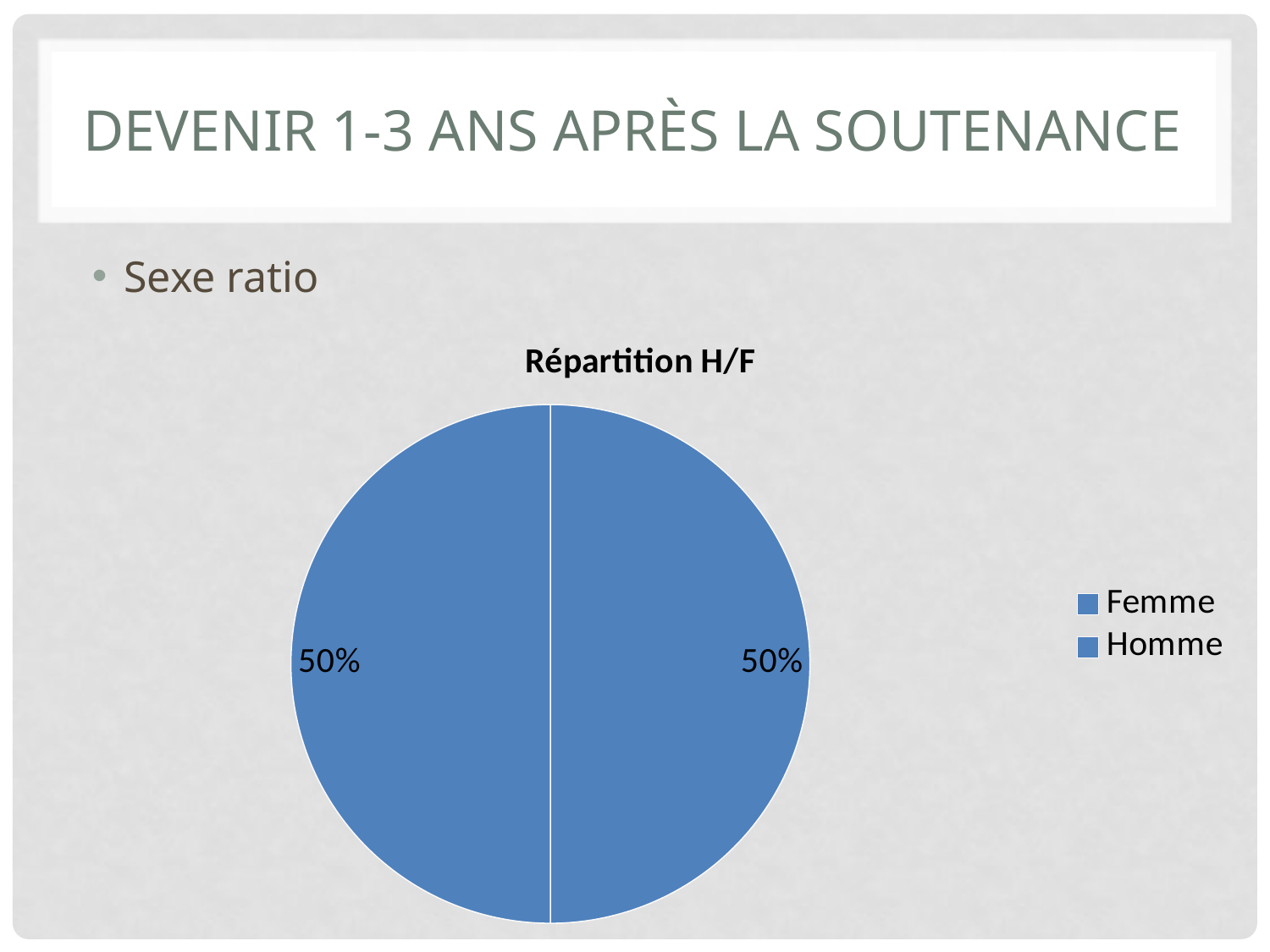
What value is printed on the right slice of the pie? 50% How many entries does the chart legend list? 2 How many slices does the pie chart have? 2 What share of the pie is labelled for Femme? 50% What is the difference between the Femme share and the Homme share? 0% What share of the pie is labelled for Homme? 50% What value is printed on the left slice of the pie? 50% What kind of chart is shown on the slide? pie chart What are the two categories listed in the legend? Femme and Homme What is the title of the chart? Répartition H/F